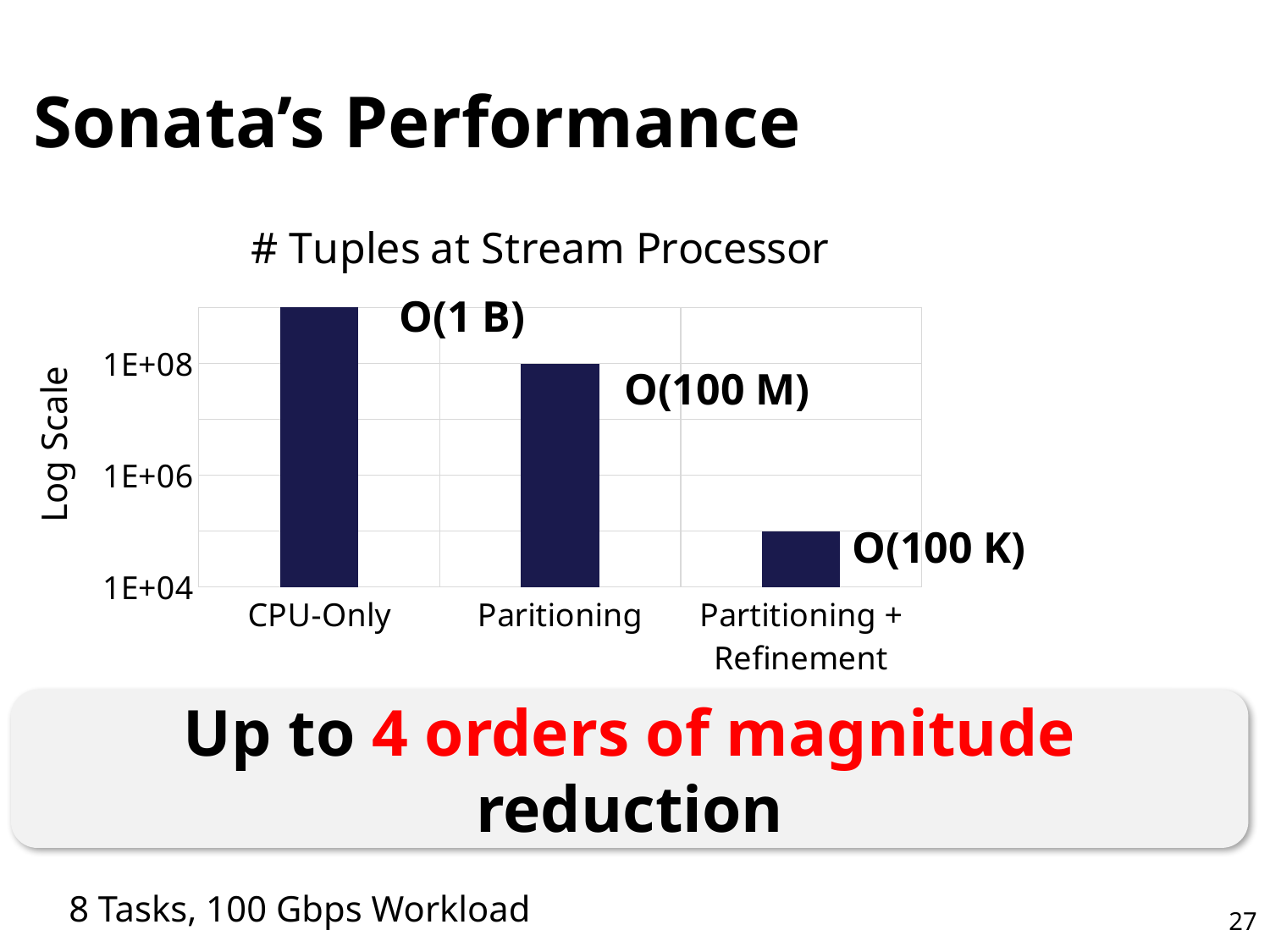
What kind of chart is shown on the slide? bar chart Which category has the highest number of tuples at the stream processor? CPU-Only Is the value for Paritioning + Refinement greater or less than 1E+06? less Which category has the lowest number of tuples at the stream processor? Partitioning + Refinement Which is larger, the value for Paritioning or the value for Paritioning + Refinement? Paritioning Do the bar values rise or fall from left to right across the x axis? fall What is the title of the chart? # Tuples at Stream Processor Is the value for CPU-Only greater or less than 1E+08? greater How many categories are shown on the x axis of the chart? 3 What label is printed next to the Paritioning bar? O(100 M) What label is printed next to the Paritioning + Refinement bar? O(100 K) What label is printed next to the CPU-Only bar? O(1 B)